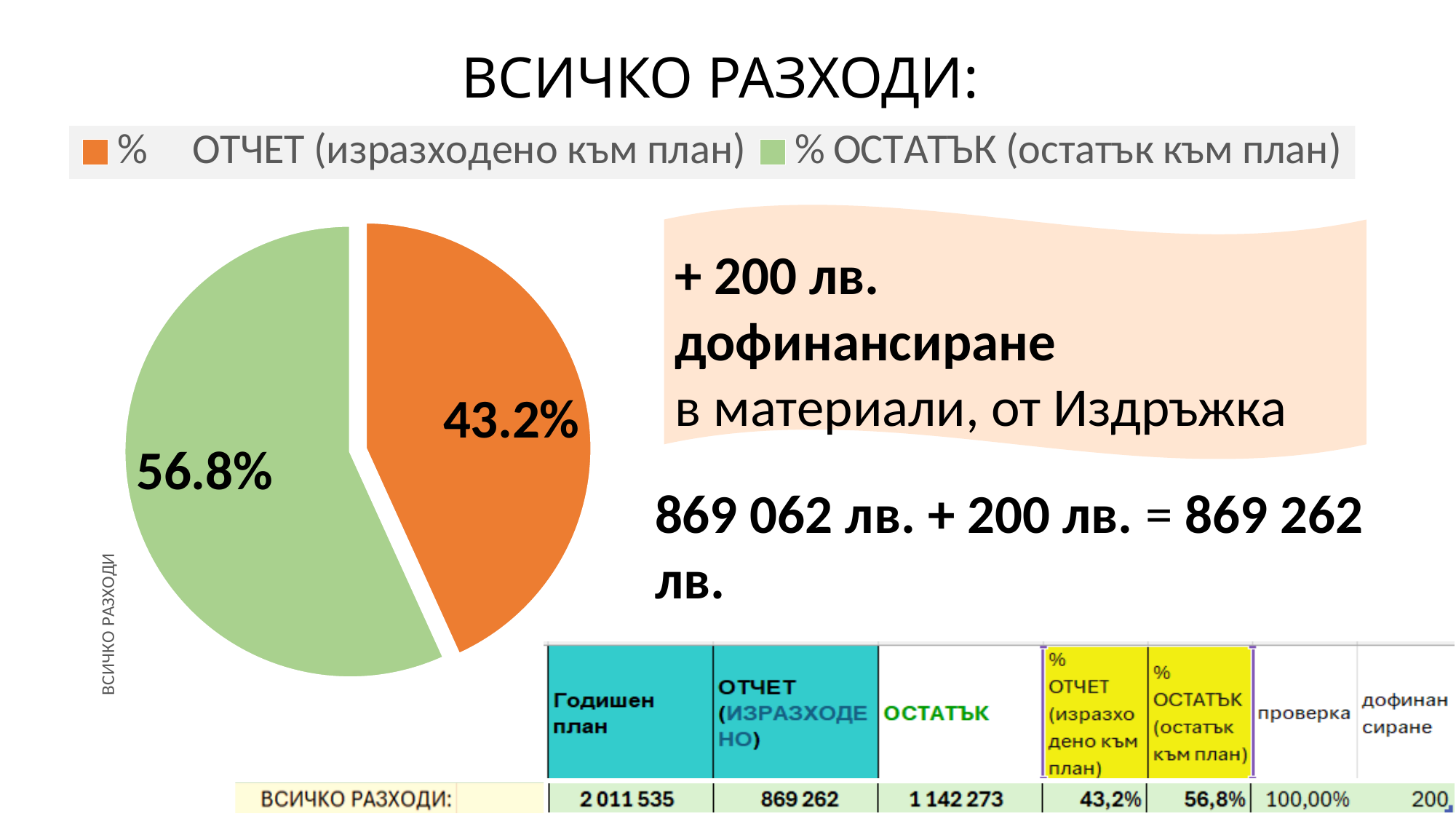
How many entries does the legend of the pie chart list? 2 What is the difference between the % ОСТАТЪК slice and the % ОТЧЕТ slice in the pie chart? 13.6% What colour is the % ОТЧЕТ (изразходено към план) slice in the pie chart? orange Which slice of the pie chart is the largest? % ОСТАТЪК (остатък към план) What kind of chart is shown on the slide? pie chart What is the value of the % ОСТАТЪК (остатък към план) slice in the pie chart? 56.8% What is the title of the slide containing the pie chart? ВСИЧКО РАЗХОДИ: Which slice of the pie chart is the smallest? % ОТЧЕТ (изразходено към план) What share of the pie does the green slice represent? 56.8% What is the value of the % ОТЧЕТ (изразходено към план) slice in the pie chart? 43.2% Which is larger in the pie chart: the % ОТЧЕТ slice or the % ОСТАТЪК slice? % ОСТАТЪК How many slices does the pie chart have? 2